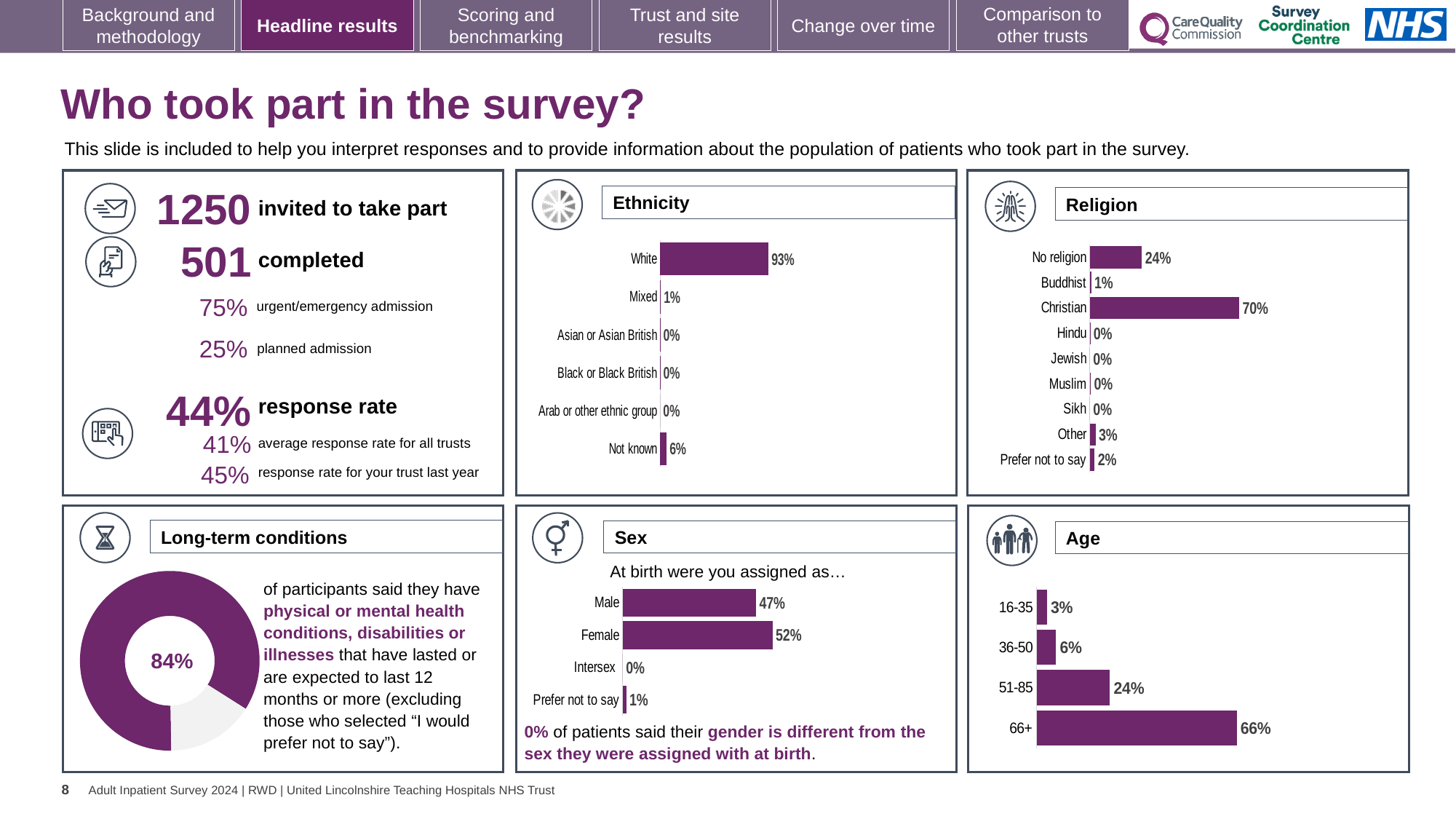
In the Ethnicity chart, what percentage of respondents were White? 93% In the Sex chart, what is the difference between the Female and Male values? 5% How many categories are shown in the Religion chart? 9 How many age groups are shown in the Age chart? 4 In the Sex chart, which is larger, Male or Female? Female In the Age chart, do the values rise or fall from 16-35 to 66+? rise In the Age chart, what is the value for 51-85? 24% In the Long-term conditions chart, what share of participants said they have long-term conditions? 84% In the Religion chart, what is the value for No religion? 24% In the Age chart, which age group has the highest value? 66+ In the Religion chart, which category has the highest value? Christian What kind of chart is the Long-term conditions chart? doughnut chart